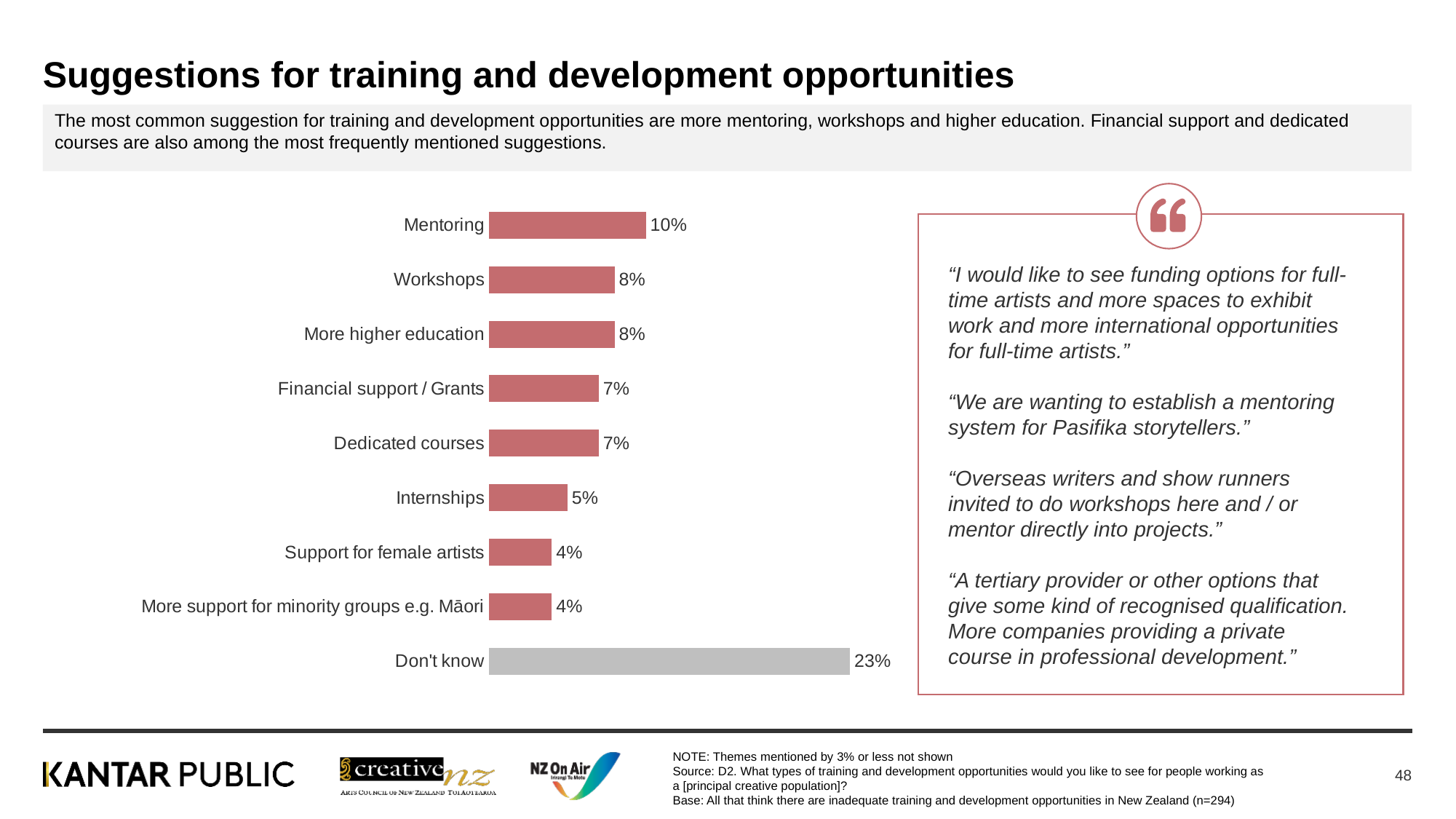
What type of chart is shown on the slide? Bar chart How many categories are shown in the bar chart? 9 What percentage is shown for Internships? 5% What percentage is shown for Support for female artists? 4% What is the difference between the values for Mentoring and Workshops? 2% What is the difference between the values for Don't know and Mentoring? 13% Which bar is coloured grey rather than red? Don't know Excluding Don't know, which suggestion has the highest percentage? Mentoring Which category has the highest value in the chart? Don't know What percentage is shown for Mentoring? 10% What percentage is shown for Don't know? 23% Which is larger, the value for Financial support / Grants or the value for Internships? Financial support / Grants